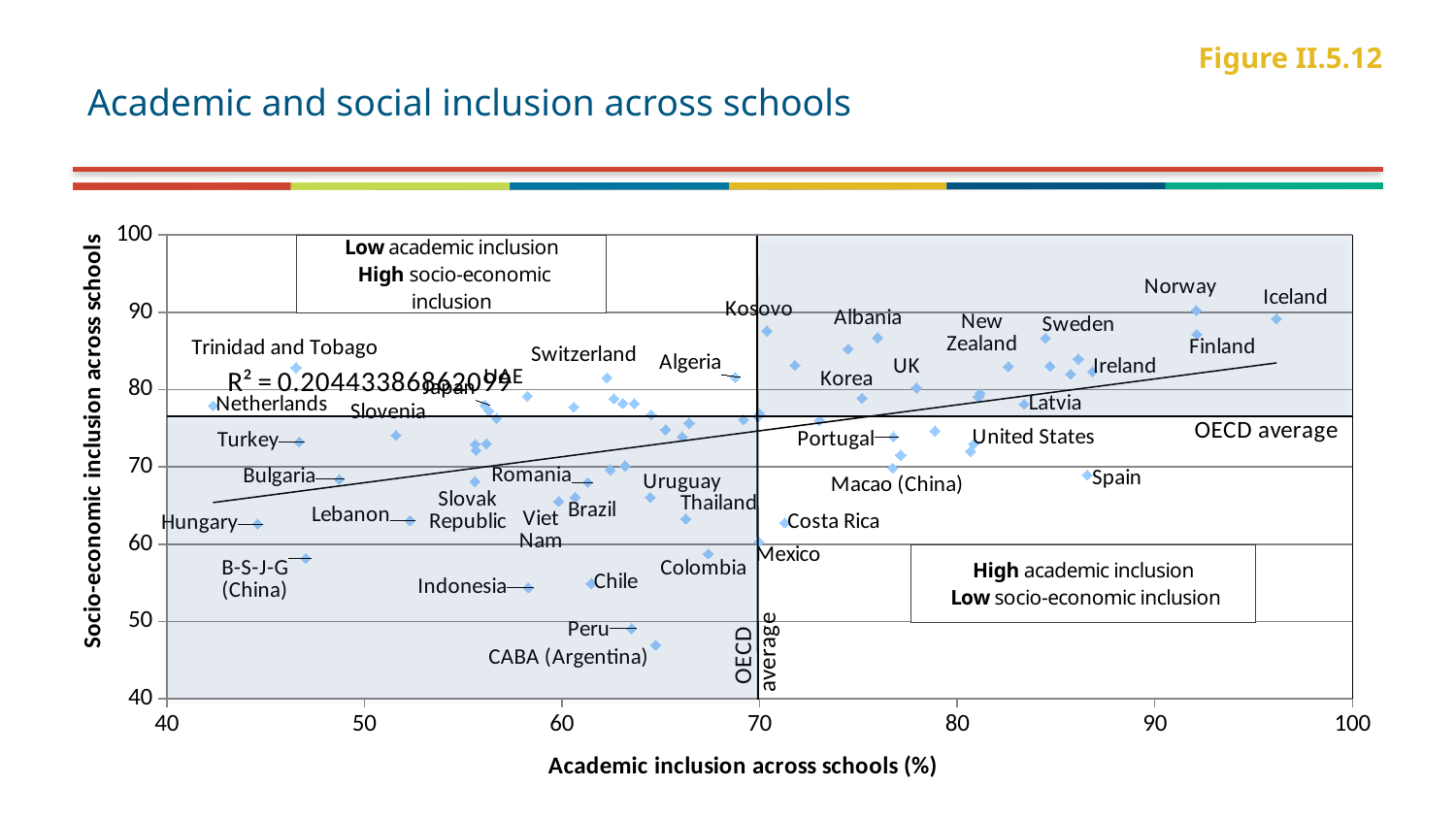
Which has the higher socio-economic inclusion across schools, Norway or Peru? Norway Which labelled country has the highest academic inclusion across schools? Iceland Is the socio-economic inclusion value for Indonesia greater or less than 60? less Is the academic inclusion value for Iceland greater or less than 90? greater Is the socio-economic inclusion value for Kosovo greater or less than 80? greater Which has the higher academic inclusion across schools, Iceland or Hungary? Iceland What is the title of the chart? Academic and social inclusion across schools What is the R² value printed on the chart? 0.204433868620799 What kind of chart is shown on the slide? scatter chart Does the fitted trend line rise or fall as academic inclusion increases? rises